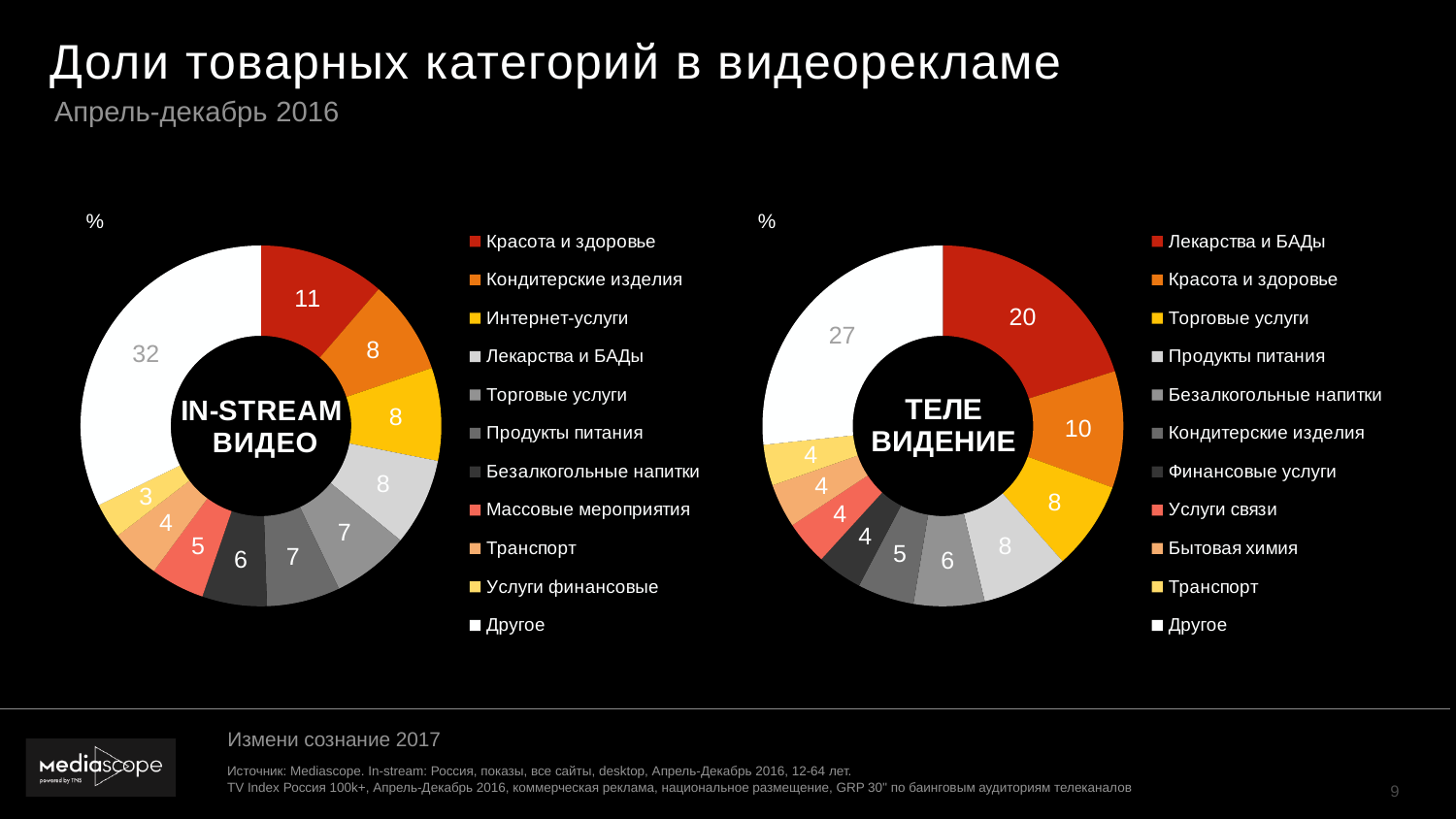
On the ТЕЛЕВИДЕНИЕ chart, what is the difference between the shares of Лекарства и БАДы and Красота и здоровье? 10 On the IN-STREAM ВИДЕО chart, what is the difference between the shares of Другое and Красота и здоровье? 21 Which is larger: the share of Красота и здоровье on the IN-STREAM ВИДЕО chart or on the ТЕЛЕВИДЕНИЕ chart? IN-STREAM ВИДЕО On the IN-STREAM ВИДЕО chart, what is the share for Красота и здоровье? 11 On the ТЕЛЕВИДЕНИЕ chart, what is the share for Красота и здоровье? 10 On the ТЕЛЕВИДЕНИЕ chart, which is larger: Безалкогольные напитки or Кондитерские изделия? Безалкогольные напитки What kind of chart is used for IN-STREAM ВИДЕО? Pie (donut) chart On the IN-STREAM ВИДЕО chart, which category has the largest share? Другое What is the title of the slide? Доли товарных категорий в видеорекламе How many categories does the legend of the ТЕЛЕВИДЕНИЕ chart list? 11 On the IN-STREAM ВИДЕО chart, which category has the smallest share? Услуги финансовые On the ТЕЛЕВИДЕНИЕ chart, what is the share for Лекарства и БАДы? 20